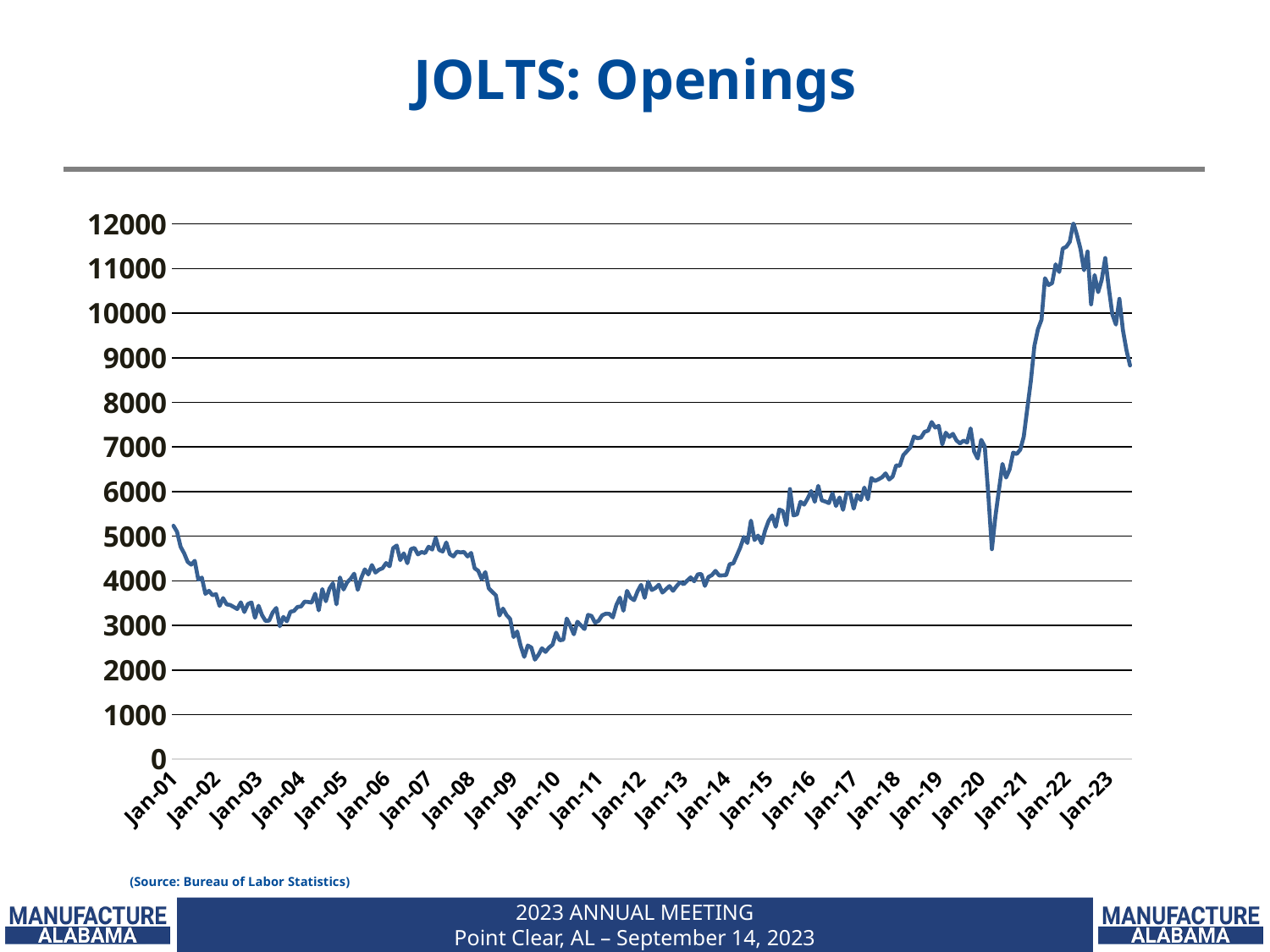
How many year labels (Jan-01 through Jan-23) are shown on the x axis? 23 Is the value at Jan-17 greater or less than 5000? greater Is the value at Jan-23 greater or less than 10000? greater Between Jan-10 and Jan-19, do the values generally rise or fall? rise Is the value at Jan-10 greater or less than 3000? less What is the title of the chart? JOLTS: Openings What kind of chart is shown on the slide? line chart Which is larger, the value at Jan-22 or the value at Jan-02? Jan-22 How many lines are plotted on the chart? 1 What source is cited for the chart data? Bureau of Labor Statistics